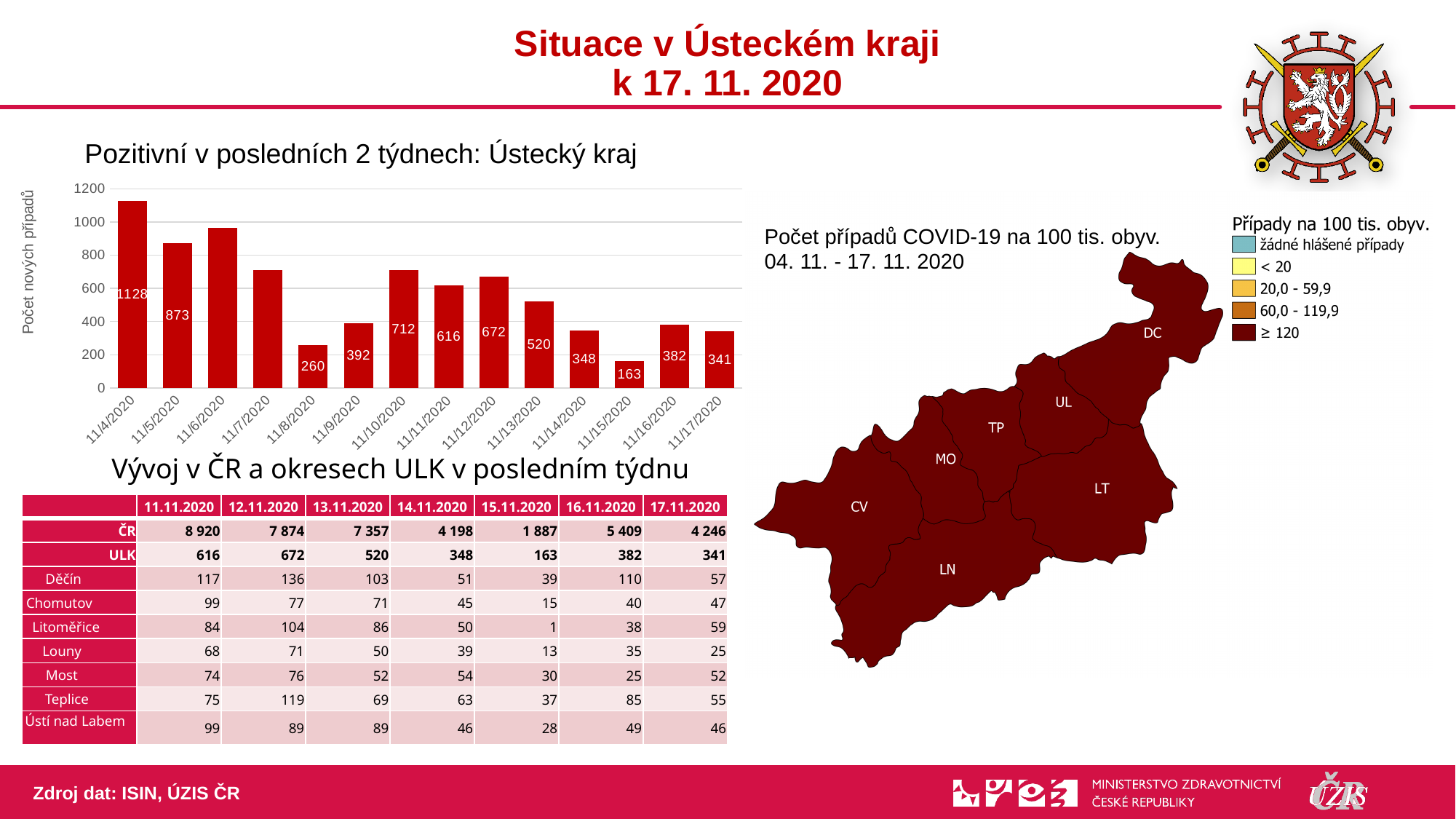
What kind of chart is 'Pozitivní v posledních 2 týdnech: Ústecký kraj'? bar chart In the bar chart 'Pozitivní v posledních 2 týdnech: Ústecký kraj', do the values rise or fall from 11/12/2020 to 11/15/2020? fall In the bar chart 'Pozitivní v posledních 2 týdnech: Ústecký kraj', which date has the highest value? 11/4/2020 In the bar chart 'Pozitivní v posledních 2 týdnech: Ústecký kraj', which date has the lowest value? 11/15/2020 In the bar chart 'Pozitivní v posledních 2 týdnech: Ústecký kraj', what is the difference between the values for 11/4/2020 and 11/5/2020? 255 In the bar chart 'Pozitivní v posledních 2 týdnech: Ústecký kraj', is the value for 11/6/2020 greater or less than 800? greater In the bar chart 'Pozitivní v posledních 2 týdnech: Ústecký kraj', what is the value for 11/4/2020? 1128 What is the y-axis title of the bar chart 'Pozitivní v posledních 2 týdnech: Ústecký kraj'? Počet nových případů In the bar chart 'Pozitivní v posledních 2 týdnech: Ústecký kraj', is the value for 11/7/2020 greater or less than 600? greater How many dates (bars) are shown in the bar chart 'Pozitivní v posledních 2 týdnech: Ústecký kraj'? 14 In the bar chart 'Pozitivní v posledních 2 týdnech: Ústecký kraj', which is larger: the value for 11/13/2020 or 11/16/2020? 11/13/2020 In the bar chart 'Pozitivní v posledních 2 týdnech: Ústecký kraj', what is the value for 11/12/2020? 672